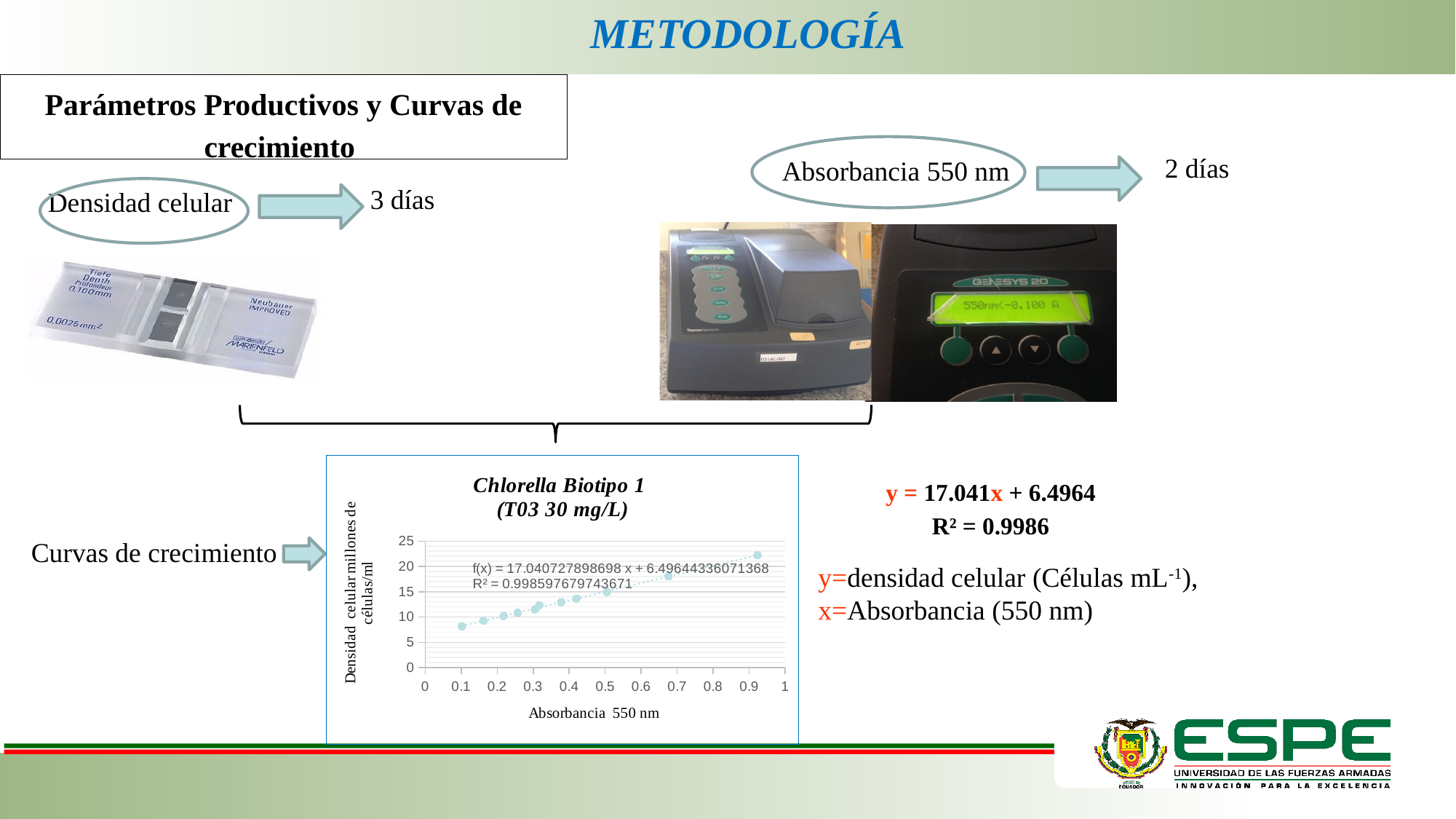
Is the cell density for the point near absorbance 0.7 greater or less than 15? greater Is the cell density for the point at absorbance 0.1 greater or less than 10? less Is the cell density for the point near absorbance 0.9 greater or less than 20? greater What R² value is printed on the chart? R² = 0.998597679743671 Do the plotted values of cell density rise or fall as absorbance increases along the x axis? rise Which point has the highest cell density: the one at the lowest absorbance or the one at the highest absorbance? the one at the highest absorbance Which point has the lowest cell density: the one at the lowest absorbance or the one at the highest absorbance? the one at the lowest absorbance What kind of chart is shown on the slide? scatter chart What is the title of the chart on the slide? Chlorella Biotipo 1 (T03 30 mg/L) Which point has the higher cell density: the one at absorbance 0.1 or the one near absorbance 0.9? the one near absorbance 0.9